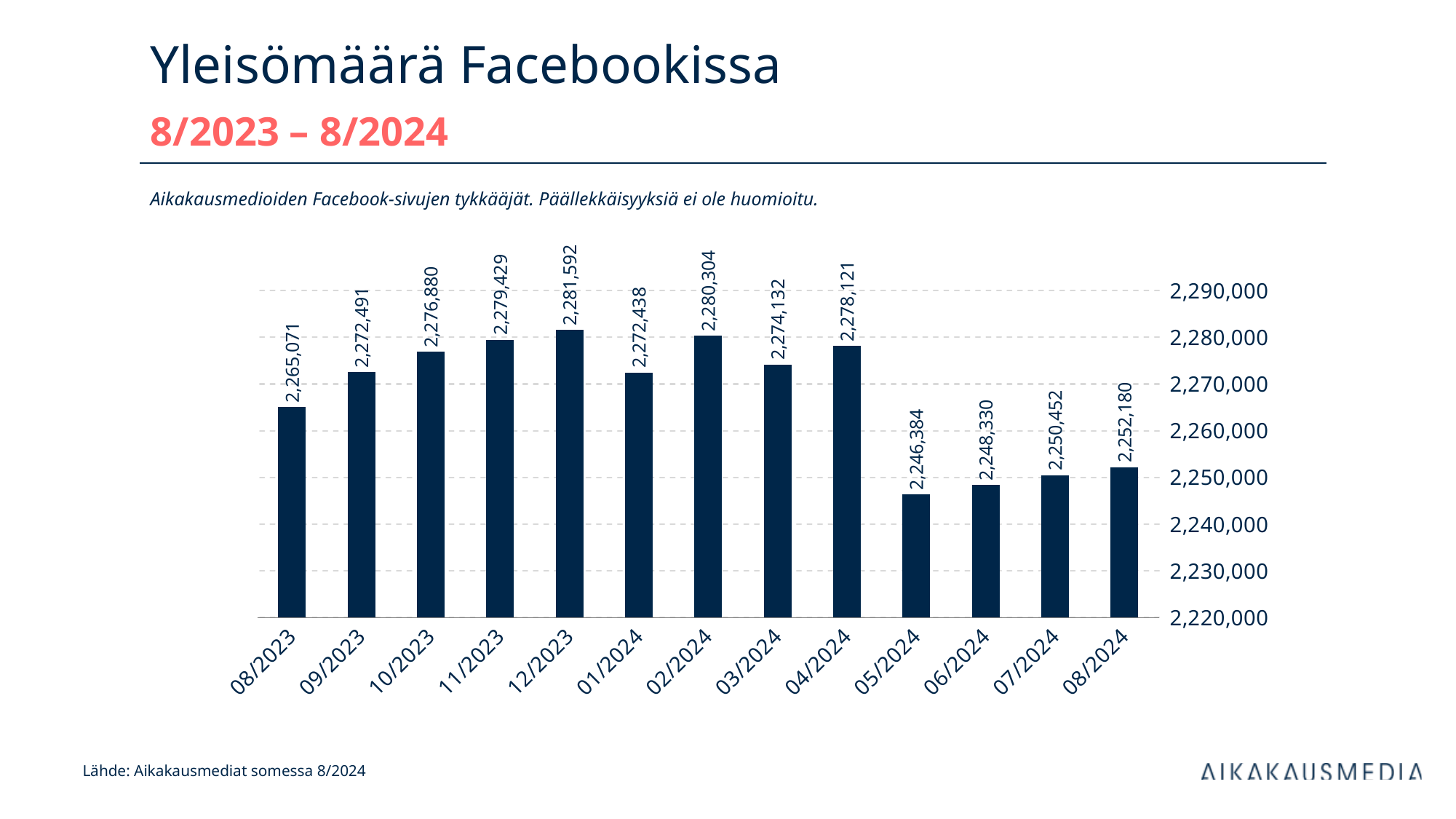
Is the value for 06/2024 greater or less than 2,250,000? less Which month has the lowest value? 05/2024 What is the difference between the values for 08/2023 and 08/2024? 12,891 Do the values rise or fall from 05/2024 to 08/2024? rise What is the value for 05/2024? 2,246,384 What kind of chart is shown on the slide? bar chart How many months are shown on the chart? 13 Which month has the highest value? 12/2023 What is the difference between the values for 12/2023 and 05/2024? 35,208 What is the value for 12/2023? 2,281,592 Which is larger, the value for 02/2024 or the value for 04/2024? 02/2024 What is the value for 08/2024? 2,252,180